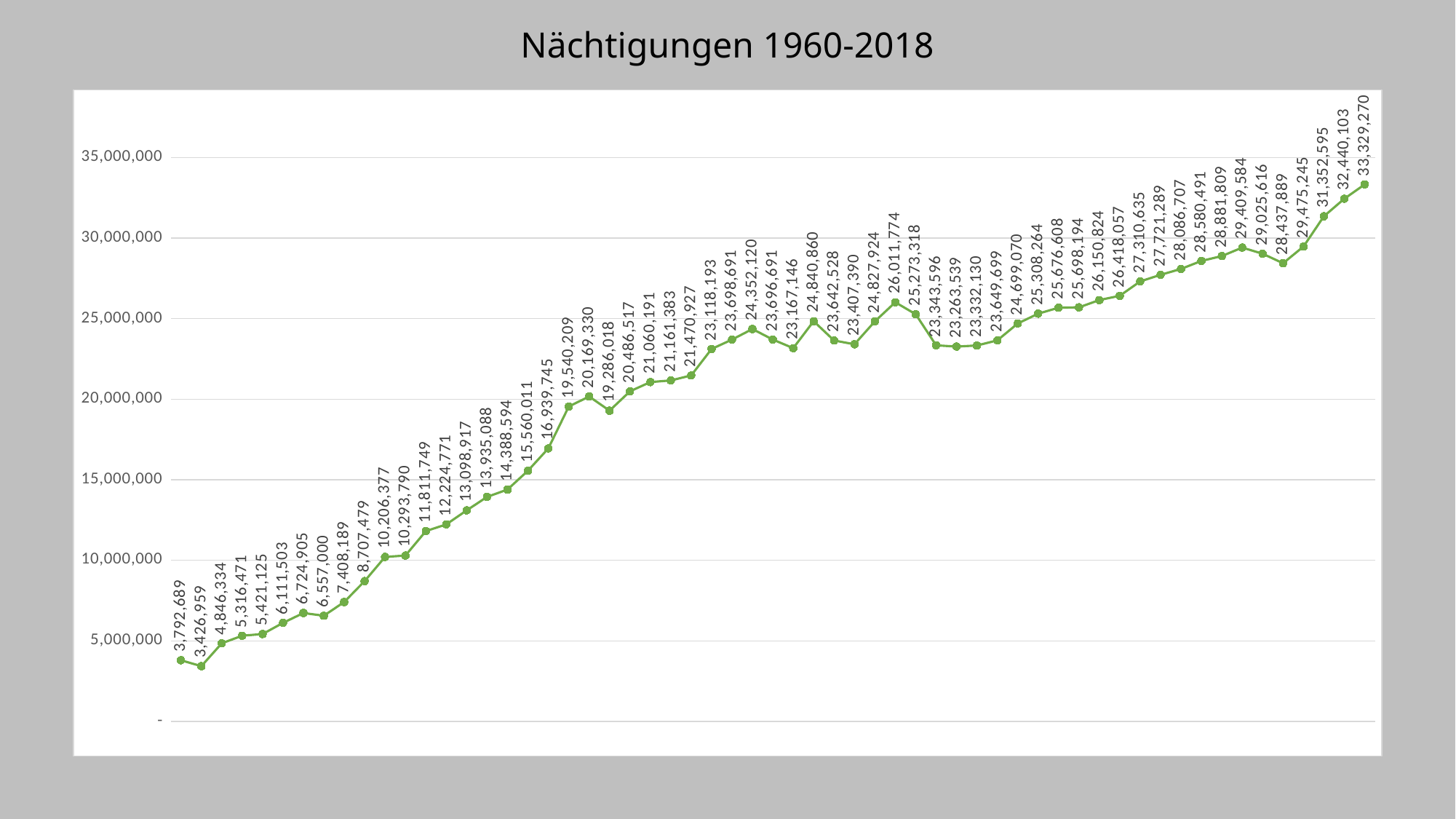
How many data points are plotted on the line? 59 What is the value of the last data point on the line? 33,329,270 What kind of chart is shown on the slide? line chart What is the lowest value plotted on the chart? 3,426,959 What colour is the plotted line? green What is the difference between the last data point and the first data point? 29,536,581 Overall, do the values rise or fall from left to right along the x axis? rise Is the value of the last data point greater or less than 30,000,000? greater What is the value of the first data point on the line? 3,792,689 Which is larger, the first data point or the second data point? the first data point What is the highest value plotted on the chart? 33,329,270 What is the title of the chart? Nächtigungen 1960-2018